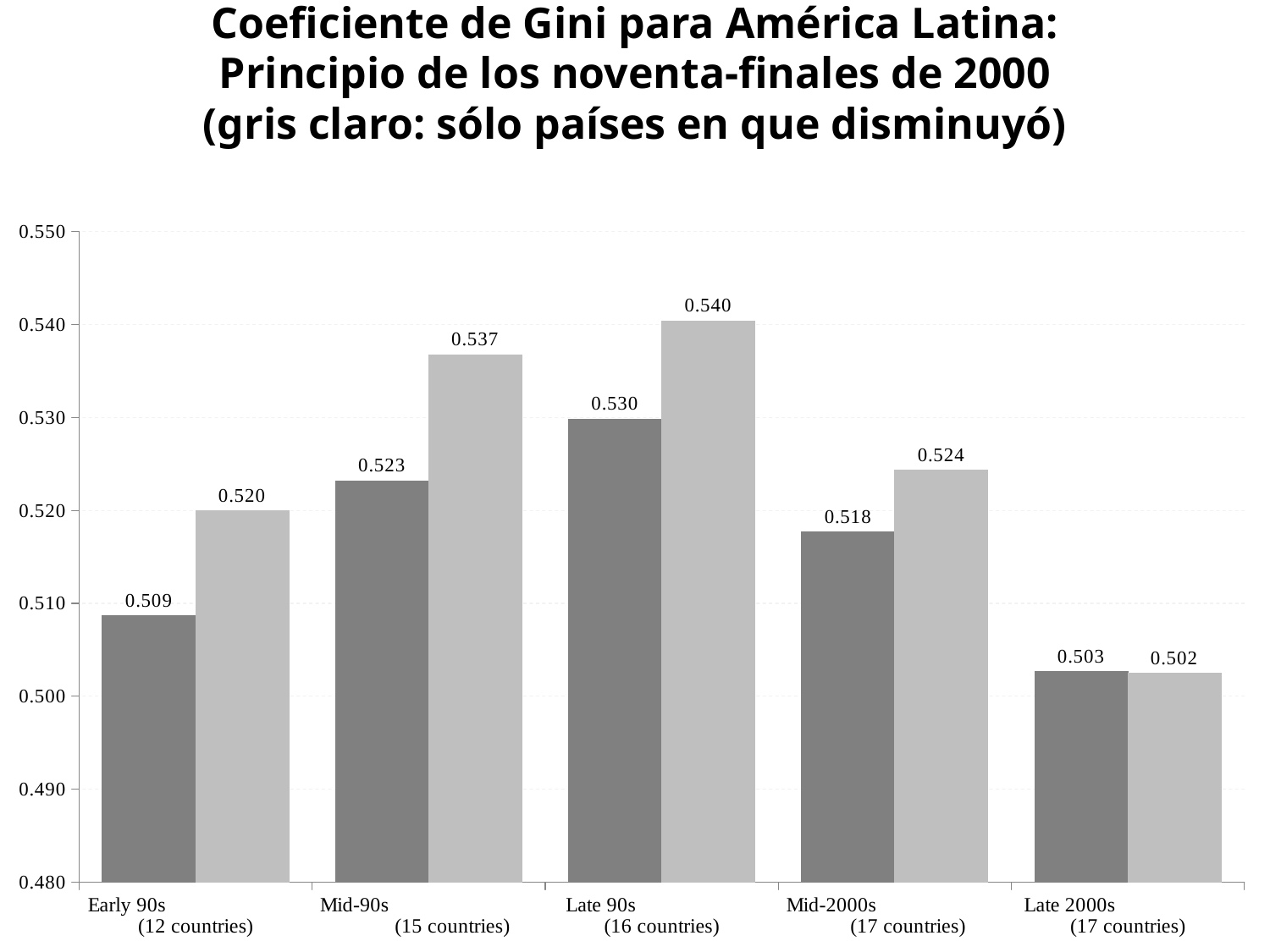
What type of chart is shown on the slide? Bar chart What is the value of the light grey bar for Mid-90s (15 countries)? 0.537 What is the difference between the dark grey bars for Late 90s (16 countries) and Mid-2000s (17 countries)? 0.012 Which period has the lowest dark grey bar? Late 2000s (17 countries) Which period has the highest light grey bar? Late 90s (16 countries) Which is larger, the light grey bar for Early 90s (12 countries) or the dark grey bar for Mid-2000s (17 countries)? Light grey bar for Early 90s (12 countries) What is the value of the dark grey bar for Late 90s (16 countries)? 0.530 What is the difference between the light grey and dark grey bars for Mid-90s (15 countries)? 0.014 How many periods are shown on the x axis? 5 Do the dark grey bars rise or fall from Late 90s (16 countries) to Late 2000s (17 countries)? Fall What is the value of the light grey bar for Late 2000s (17 countries)? 0.502 What is the value of the dark grey bar for Early 90s (12 countries)? 0.509